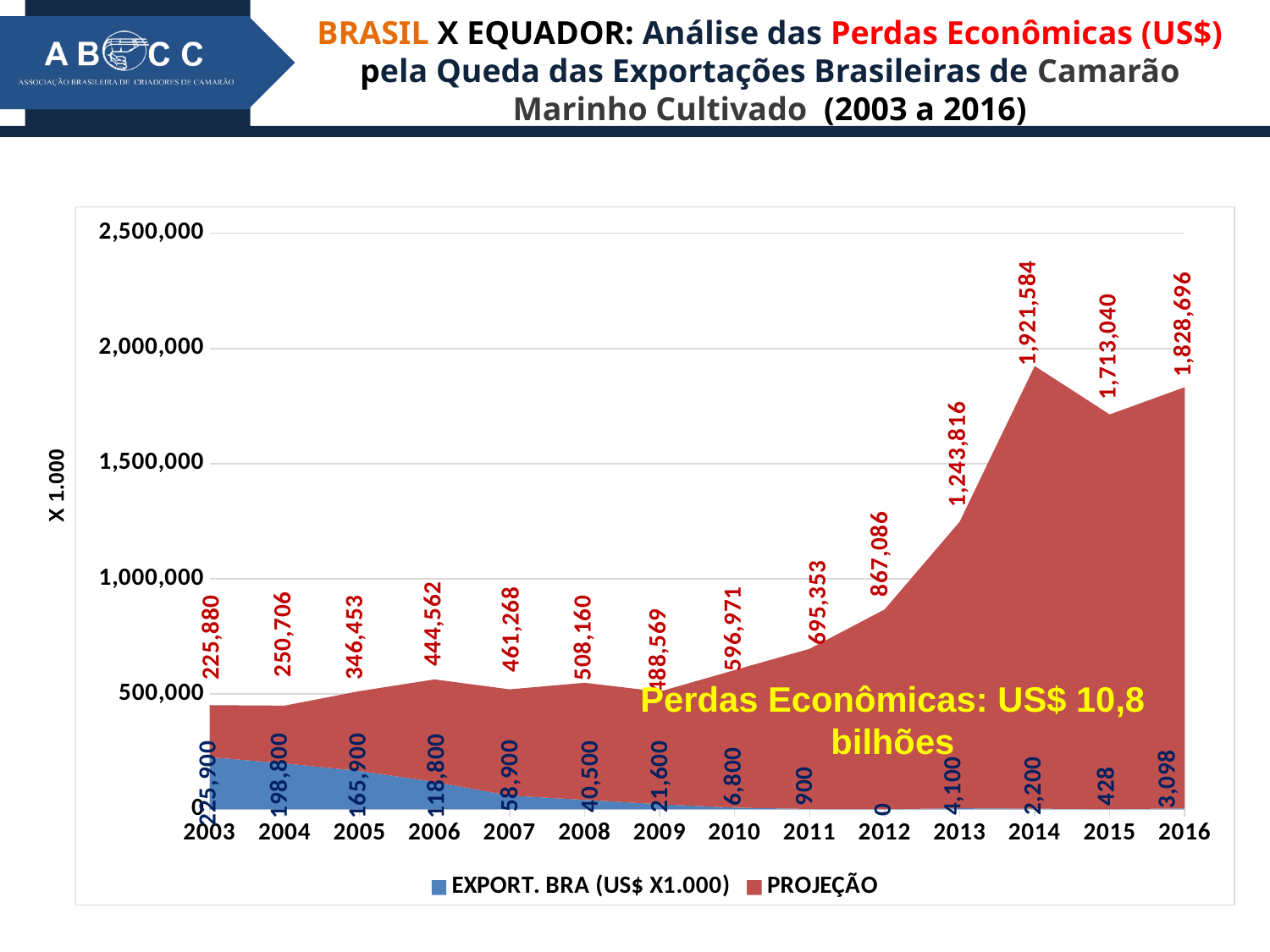
Does the EXPORT. BRA (US$ X1.000) series generally rise or fall from 2003 to 2012? Fall What kind of chart is shown on the slide? Area chart Which is larger, the PROJEÇÃO value for 2016 or for 2015? 2016 What is the difference between the PROJEÇÃO values for 2014 and 2015? 208,544 How many series does the legend list? 2 What total economic loss is stated in the yellow annotation on the chart? US$ 10,8 bilhões How many years are plotted along the x axis? 14 What is the PROJEÇÃO value for 2014? 1,921,584 In which year is the PROJEÇÃO value highest? 2014 What is the PROJEÇÃO value for 2010? 596,971 In which year is the PROJEÇÃO value lowest? 2003 What is the EXPORT. BRA (US$ X1.000) value for 2006? 118,800